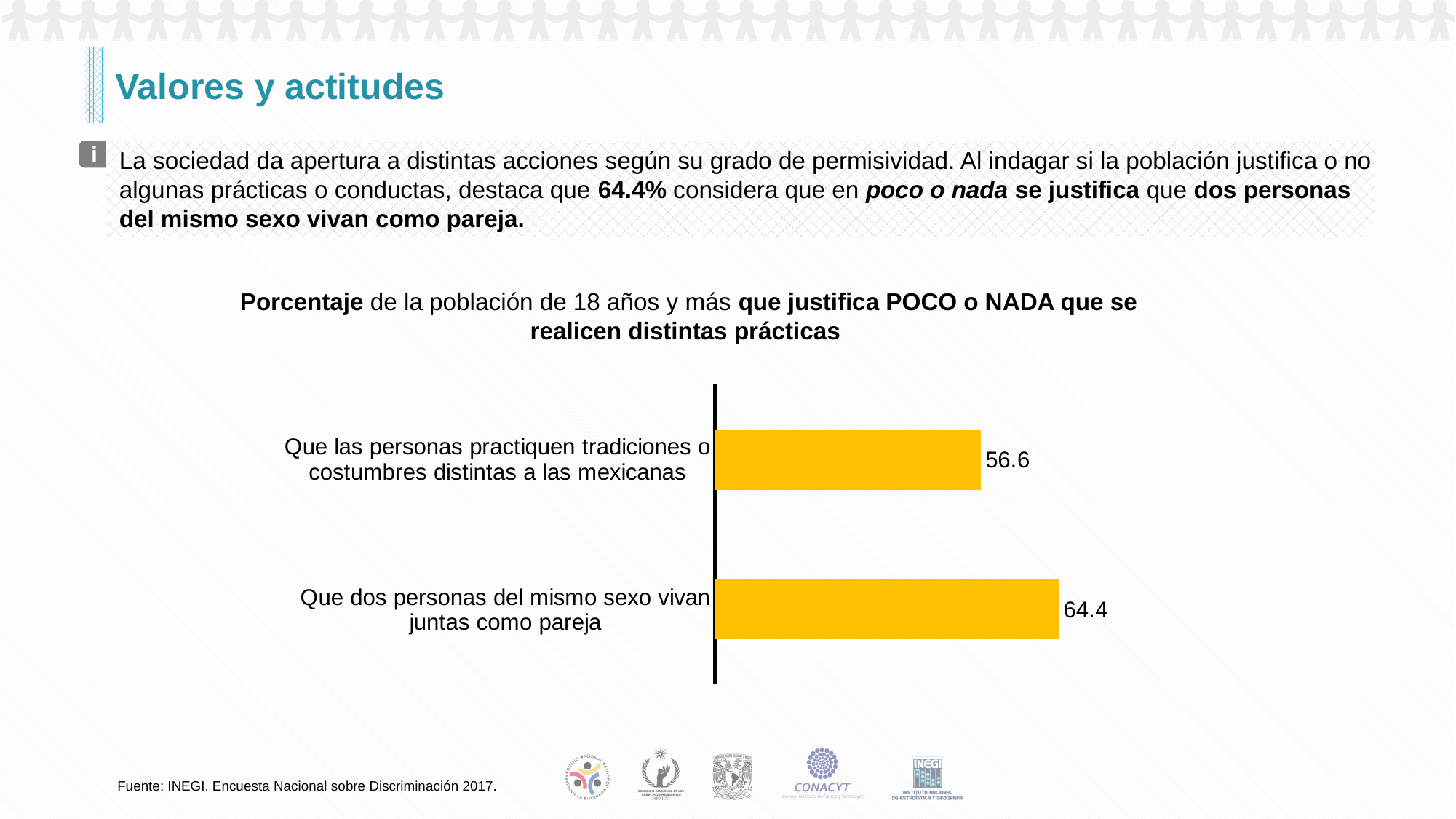
What colour are the bars in the chart? Yellow What kind of chart is shown on the slide? Bar chart What is the value for 'Que las personas practiquen tradiciones o costumbres distintas a las mexicanas'? 56.6 How many categories are shown in the chart? 2 Which category has the lowest value? Que las personas practiquen tradiciones o costumbres distintas a las mexicanas What is the value for 'Que dos personas del mismo sexo vivan juntas como pareja'? 64.4 Which category has the highest value? Que dos personas del mismo sexo vivan juntas como pareja What is the source cited for the chart? INEGI. Encuesta Nacional sobre Discriminación 2017. Which is larger: the value for 'Que las personas practiquen tradiciones o costumbres distintas a las mexicanas' or the value for 'Que dos personas del mismo sexo vivan juntas como pareja'? Que dos personas del mismo sexo vivan juntas como pareja What is the difference between the value for 'Que dos personas del mismo sexo vivan juntas como pareja' and the value for 'Que las personas practiquen tradiciones o costumbres distintas a las mexicanas'? 7.8